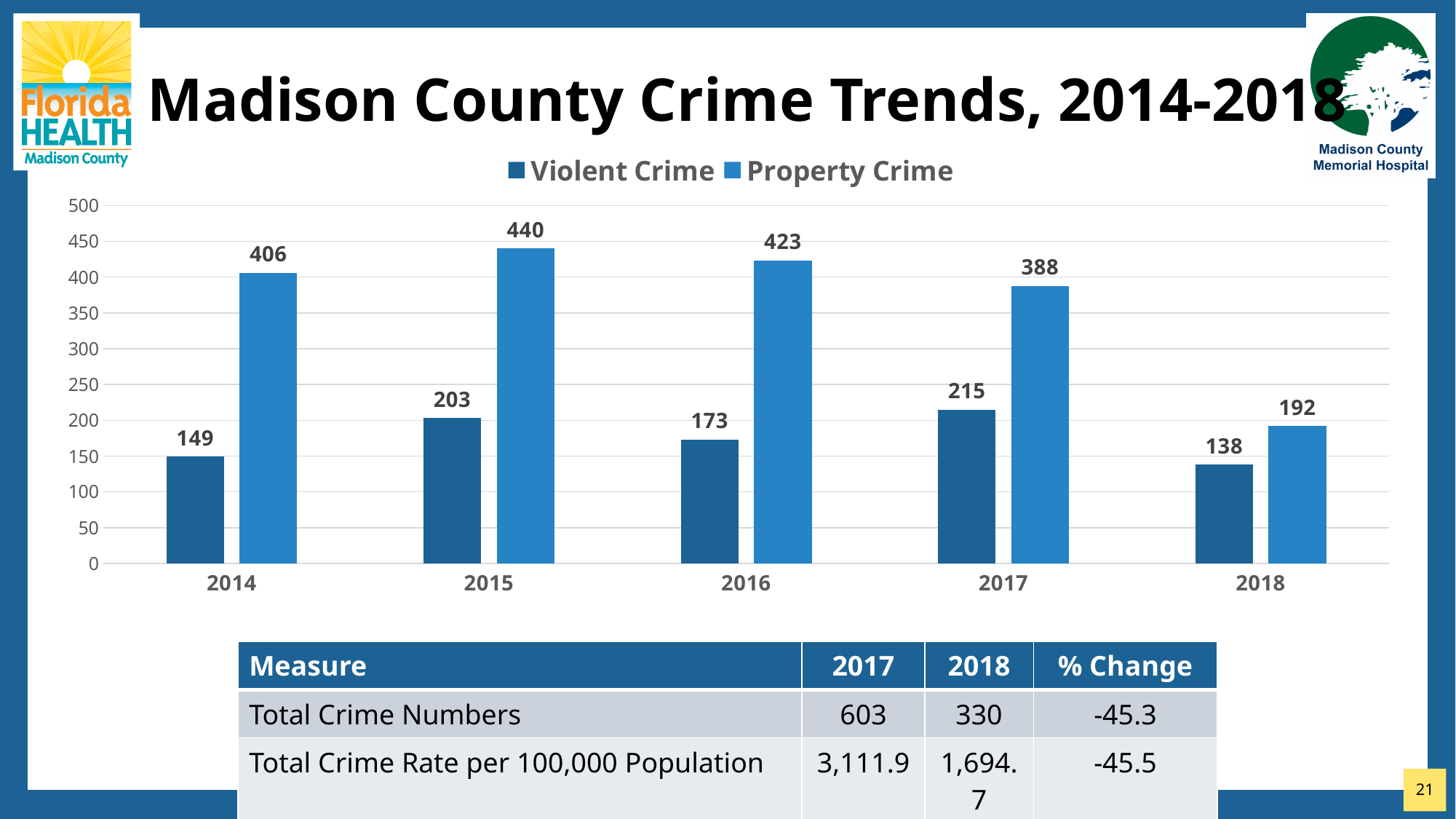
Which was larger in 2017, Violent Crime or Property Crime? Property Crime By how much did Property Crime fall from 2017 to 2018? 196 How many series does the chart legend list? 2 Did Violent Crime rise or fall from 2017 to 2018? Fall In which year was Property Crime highest? 2015 How many years are shown on the x axis of the chart? 5 In which year was Violent Crime lowest? 2018 Is the Property Crime value for 2016 greater or less than 400? greater What was the Violent Crime value in 2016? 173 What is the difference between Property Crime and Violent Crime in 2014? 257 What was the Property Crime value in 2018? 192 What kind of chart is shown on the slide? Bar chart